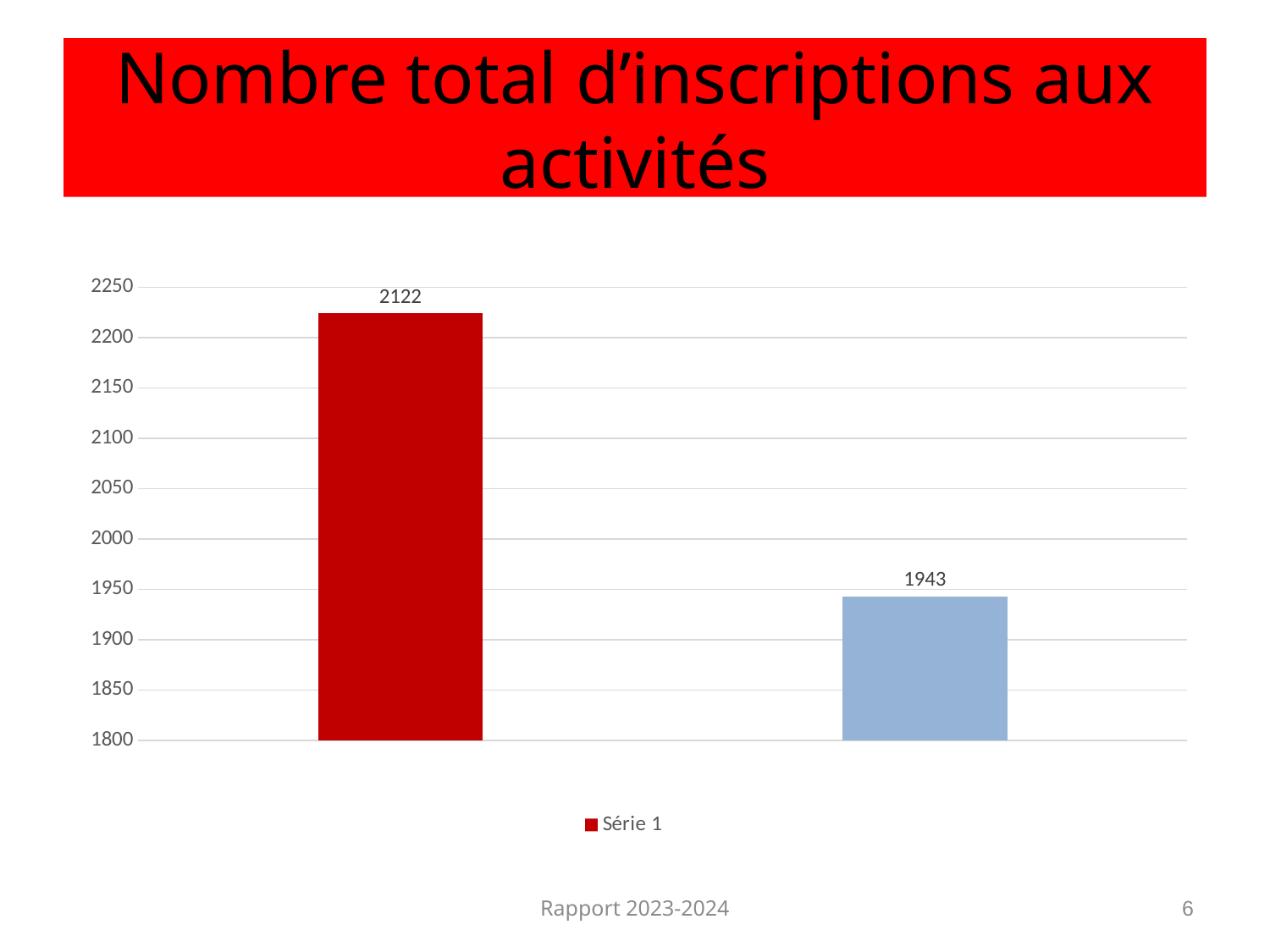
What is the value shown on the red bar on the left? 2122 What kind of chart is shown on the slide? bar chart Is the value of the blue bar on the right greater or less than 2000? less Do the values rise or fall from the left bar to the right bar? fall What is the title of the slide? Nombre total d'inscriptions aux activités What is the name of the series shown in the legend? Série 1 How many bars are plotted in the chart? 2 Is the value of the red bar on the left greater or less than 2100? greater What is the value shown on the blue bar on the right? 1943 How many series does the legend list? 1 What is the difference between the value of the red bar and the value of the blue bar? 179 Which bar is higher, the red bar on the left or the blue bar on the right? the red bar on the left